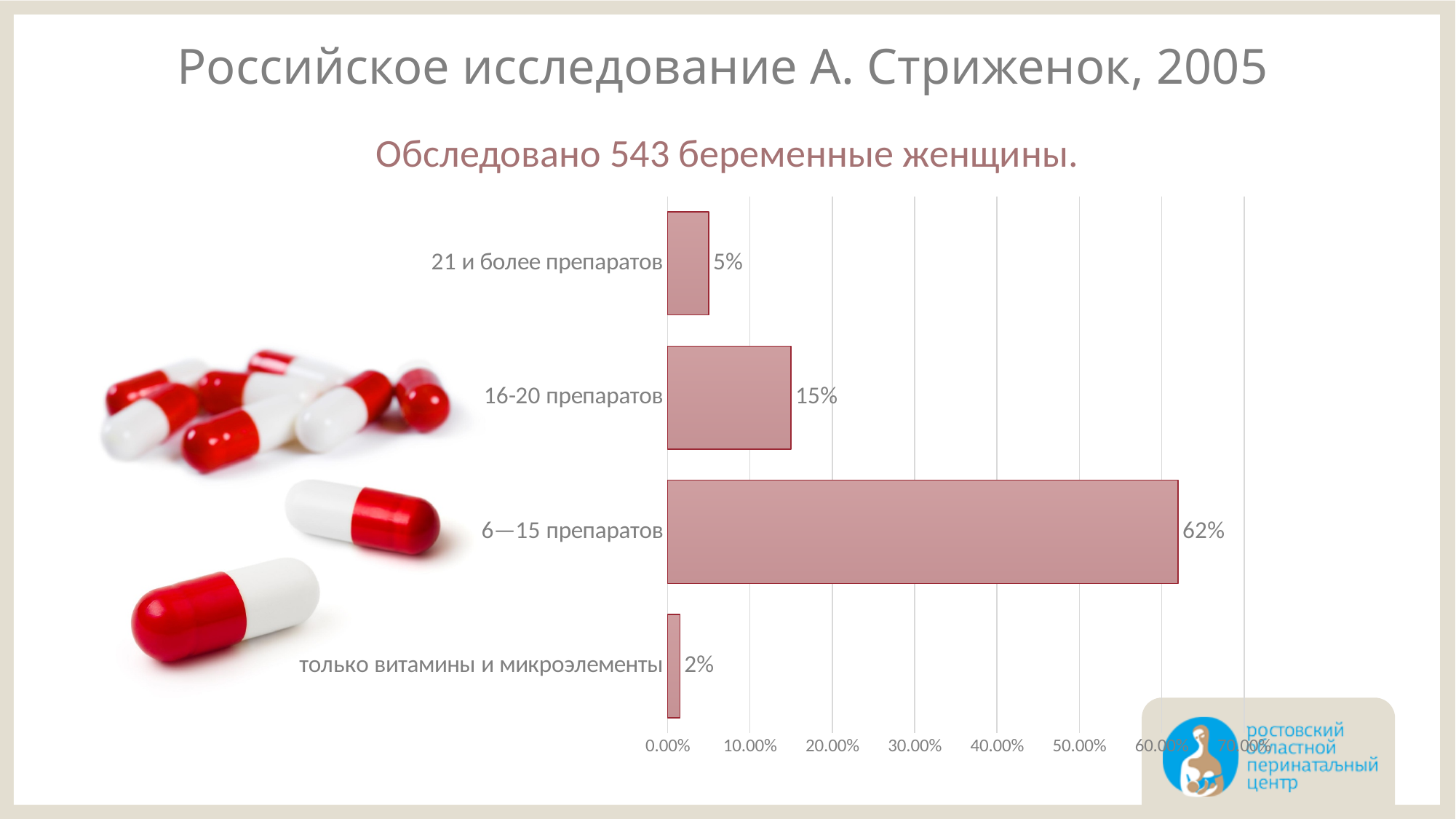
Which category has the highest value? 6—15 препаратов What kind of chart is shown on the slide? bar chart Which category has the lowest value? только витамины и микроэлементы Is the value for "6—15 препаратов" greater or less than 50.00%? greater What is the value for "21 и более препаратов"? 5% What is the subtitle shown above the chart? Обследовано 543 беременные женщины. Which is larger: the value for "21 и более препаратов" or "только витамины и микроэлементы"? 21 и более препаратов What is the difference between the values for "6—15 препаратов" and "16-20 препаратов"? 47% What is the value for "только витамины и микроэлементы"? 2% What is the value for "16-20 препаратов"? 15% How many categories are shown in the chart? 4 What is the value for "6—15 препаратов"? 62%